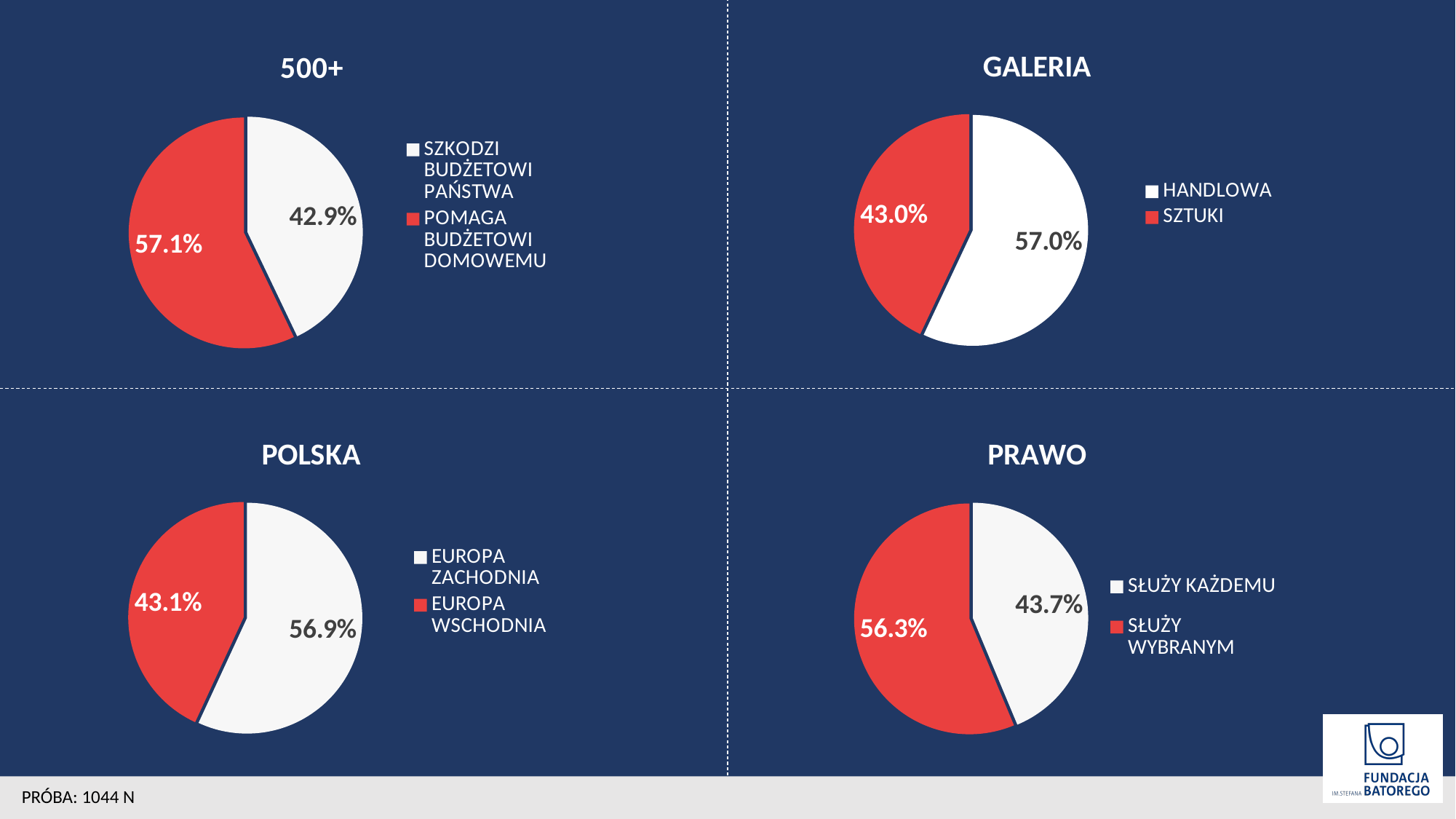
What kind of chart is the "PRAWO" chart? Pie chart In the "POLSKA" chart, which slice is the largest? EUROPA ZACHODNIA In the "PRAWO" chart, what share is labelled for SŁUŻY WYBRANYM? 56.3% In the "500+" chart, what share is labelled for POMAGA BUDŻETOWI DOMOWEMU? 57.1% In the "GALERIA" chart, what share is labelled for HANDLOWA? 57.0% In the "500+" chart, what is the difference between the two slices? 14.2% In the "GALERIA" chart, what share is labelled for SZTUKI? 43.0% In the "500+" chart, what share is labelled for SZKODZI BUDŻETOWI PAŃSTWA? 42.9% In the "POLSKA" chart, what share is labelled for EUROPA WSCHODNIA? 43.1% How many slices does the "POLSKA" chart have? 2 In the "PRAWO" chart, which slice is larger: SŁUŻY KAŻDEMU or SŁUŻY WYBRANYM? SŁUŻY WYBRANYM In the "GALERIA" chart, what is the difference between the HANDLOWA and SZTUKI shares? 14.0%